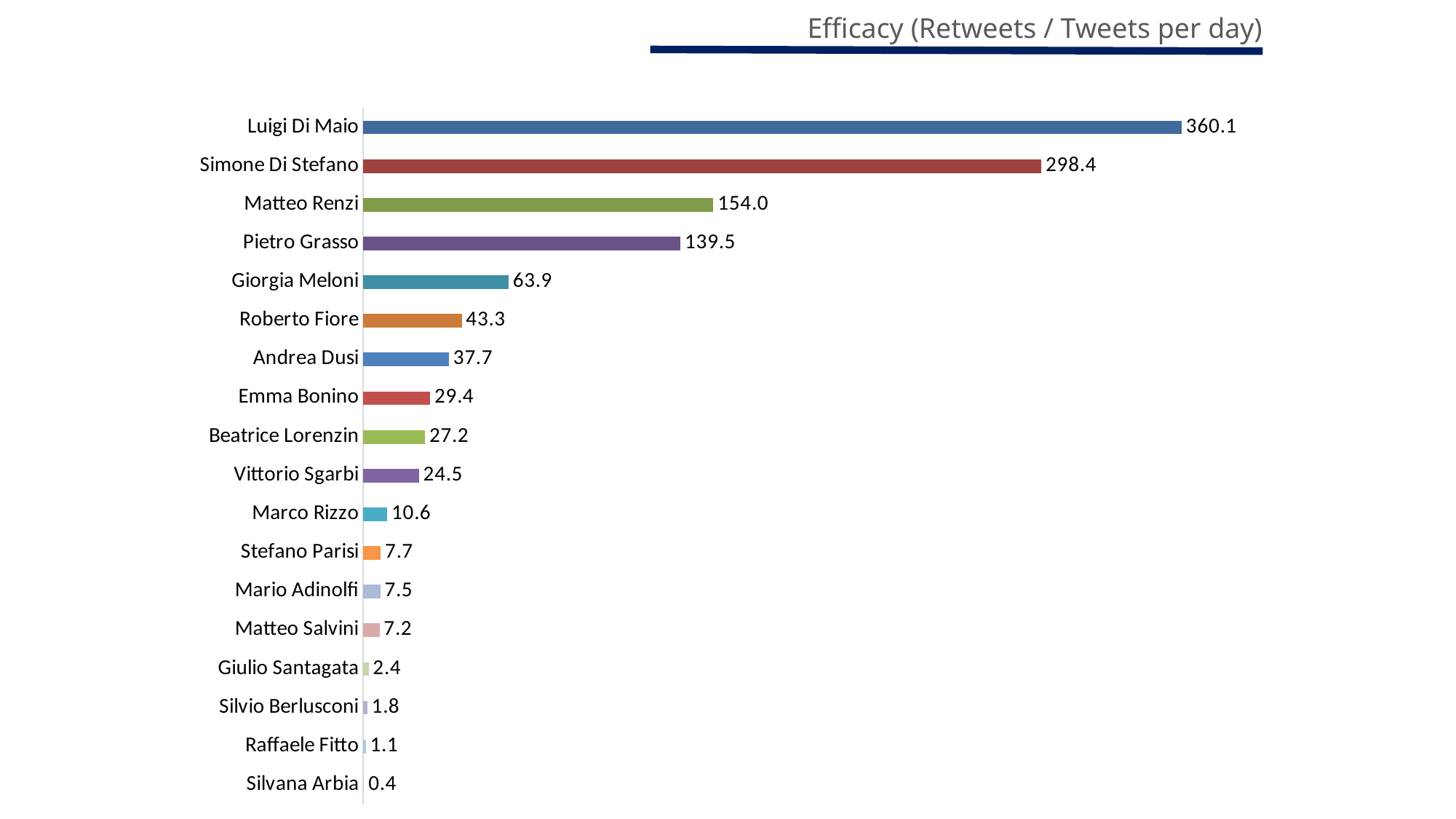
What is the difference between the efficacy values of Luigi Di Maio and Simone Di Stefano? 61.7 Who has a higher efficacy value, Roberto Fiore or Andrea Dusi? Roberto Fiore What is the efficacy value for Matteo Salvini? 7.2 How many people are shown in the chart? 18 What is the efficacy value for Luigi Di Maio? 360.1 Who has a higher efficacy value, Emma Bonino or Vittorio Sgarbi? Emma Bonino What is the difference between the efficacy values of Matteo Renzi and Pietro Grasso? 14.5 Which person has the highest efficacy value? Luigi Di Maio Which person has the lowest efficacy value? Silvana Arbia What is the efficacy value for Giorgia Meloni? 63.9 What kind of chart is shown on the slide? Bar chart What is the title of the chart? Efficacy (Retweets / Tweets per day)